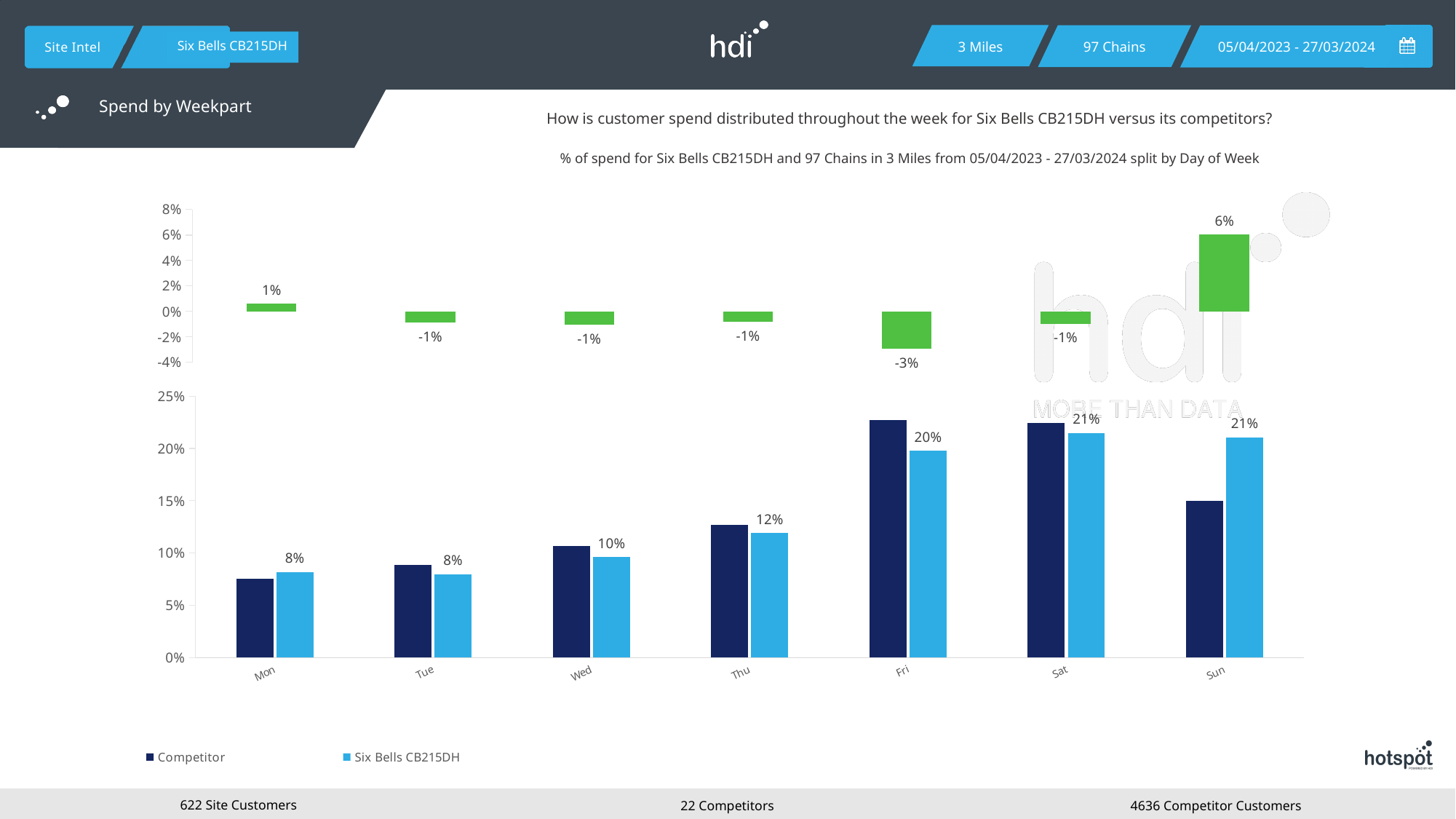
In the bottom chart, what is the difference between the Six Bells CB215DH values for Fri and Mon? 12% How many series does the legend of the bottom chart list? 2 In the bottom chart, what is the value for Six Bells CB215DH on Thu? 12% In the bottom chart, what is the value for Six Bells CB215DH on Fri? 20% In the top chart (green bars), what is the value shown for Fri? -3% In the top chart (green bars), what is the value shown for Sun? 6% In the top chart (green bars), which day has the highest value? Sun In the bottom chart, on Sun, which series has the larger value: Competitor or Six Bells CB215DH? Six Bells CB215DH How many days of the week are shown on the x axis of the bottom chart? 7 In the bottom chart, is the Competitor value for Fri greater or less than 20%? greater In the top chart (green bars), which day has the lowest value? Fri In the bottom chart, is the Competitor value for Sun greater or less than 20%? less